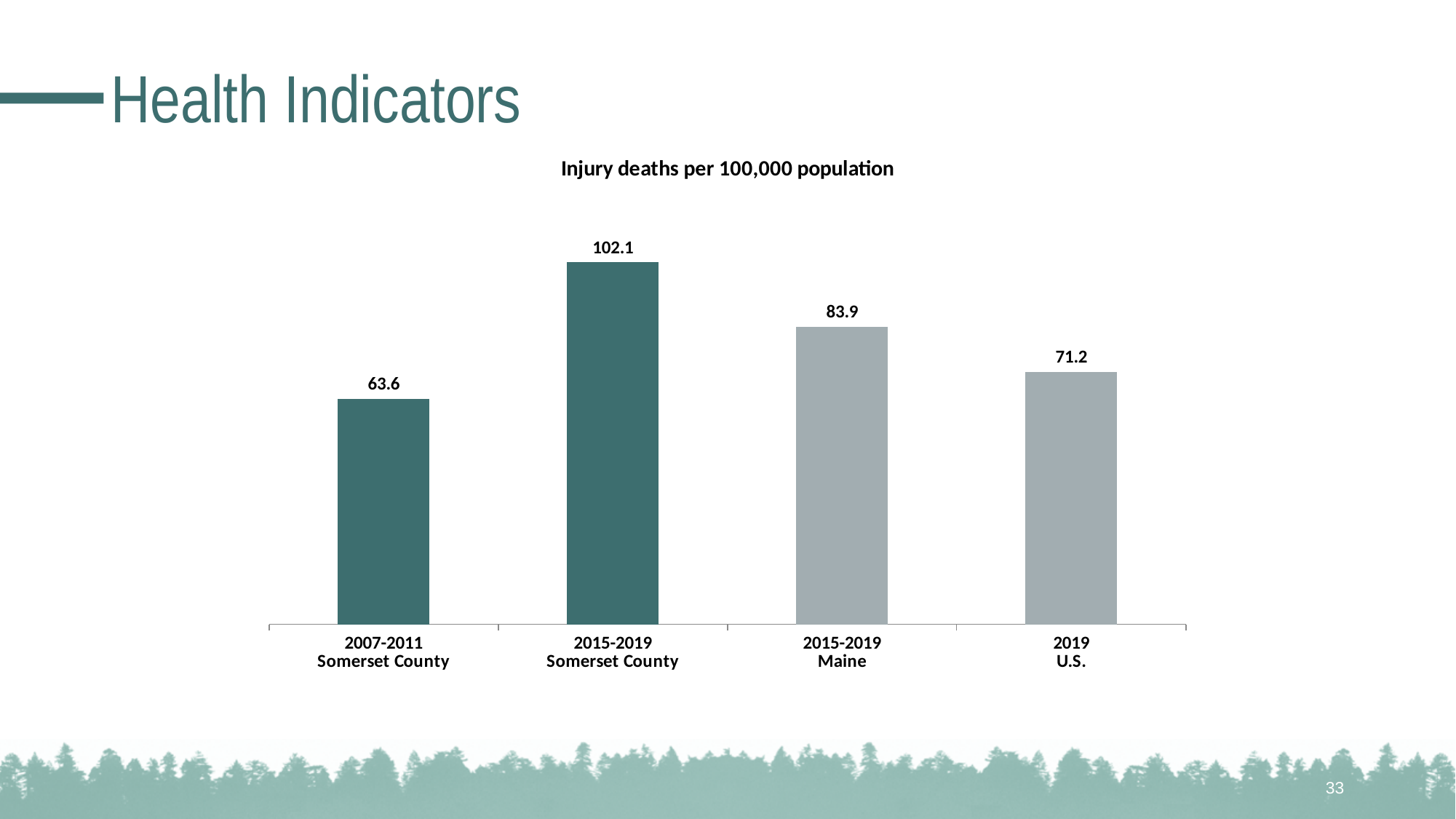
How many bars are shown in the chart? 4 What is the title of the chart? Injury deaths per 100,000 population What is the difference between the 2015-2019 Maine value and the 2019 U.S. value? 12.7 What is the value for 2007-2011 Somerset County? 63.6 What is the value for 2015-2019 Maine? 83.9 Which category has the lowest value? 2007-2011 Somerset County What is the difference between the 2015-2019 Somerset County value and the 2007-2011 Somerset County value? 38.5 Which category has the highest value? 2015-2019 Somerset County What is the value for 2019 U.S.? 71.2 What is the value for 2015-2019 Somerset County? 102.1 Which is larger, the value for 2015-2019 Maine or the value for 2019 U.S.? 2015-2019 Maine What kind of chart is shown on the slide? Bar chart